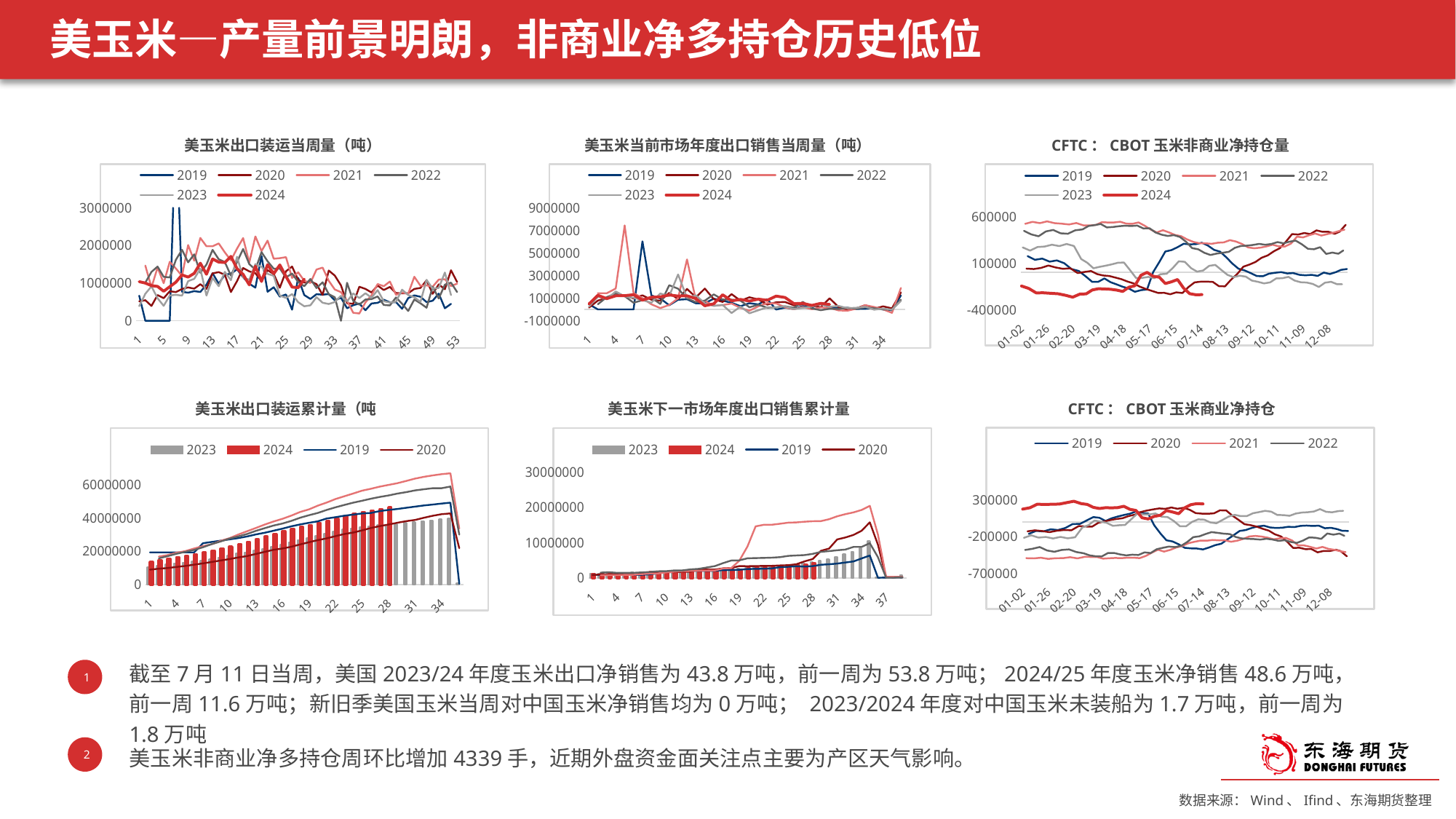
In the chart titled 美玉米当前市场年度出口销售当周量（吨）, is the peak value of the 2021 series greater or less than 5000000? greater What kind of chart is the chart titled CFTC： CBOT 玉米非商业净持仓量? line chart How many series does the legend list in the chart titled 美玉米下一市场年度出口销售累计量? 4 In the chart titled 美玉米出口装运当周量（吨）, is the peak value of the 2019 series greater or less than 2000000? greater In the chart titled 美玉米出口装运累计量（吨, which two series are drawn as bars? 2023 and 2024 In the chart titled CFTC： CBOT 玉米非商业净持仓量, is the 2021 value at 01-02 greater or less than 100000? greater How many series does the legend list in the chart titled 美玉米出口装运当周量（吨）? 6 In the chart titled 美玉米出口装运累计量（吨, do the 2024 bars rise or fall from week 1 to week 28? rise In the chart titled 美玉米出口装运累计量（吨, what colour are the 2024 bars? red How many series does the legend list in the chart titled CFTC： CBOT 玉米商业净持仓? 4